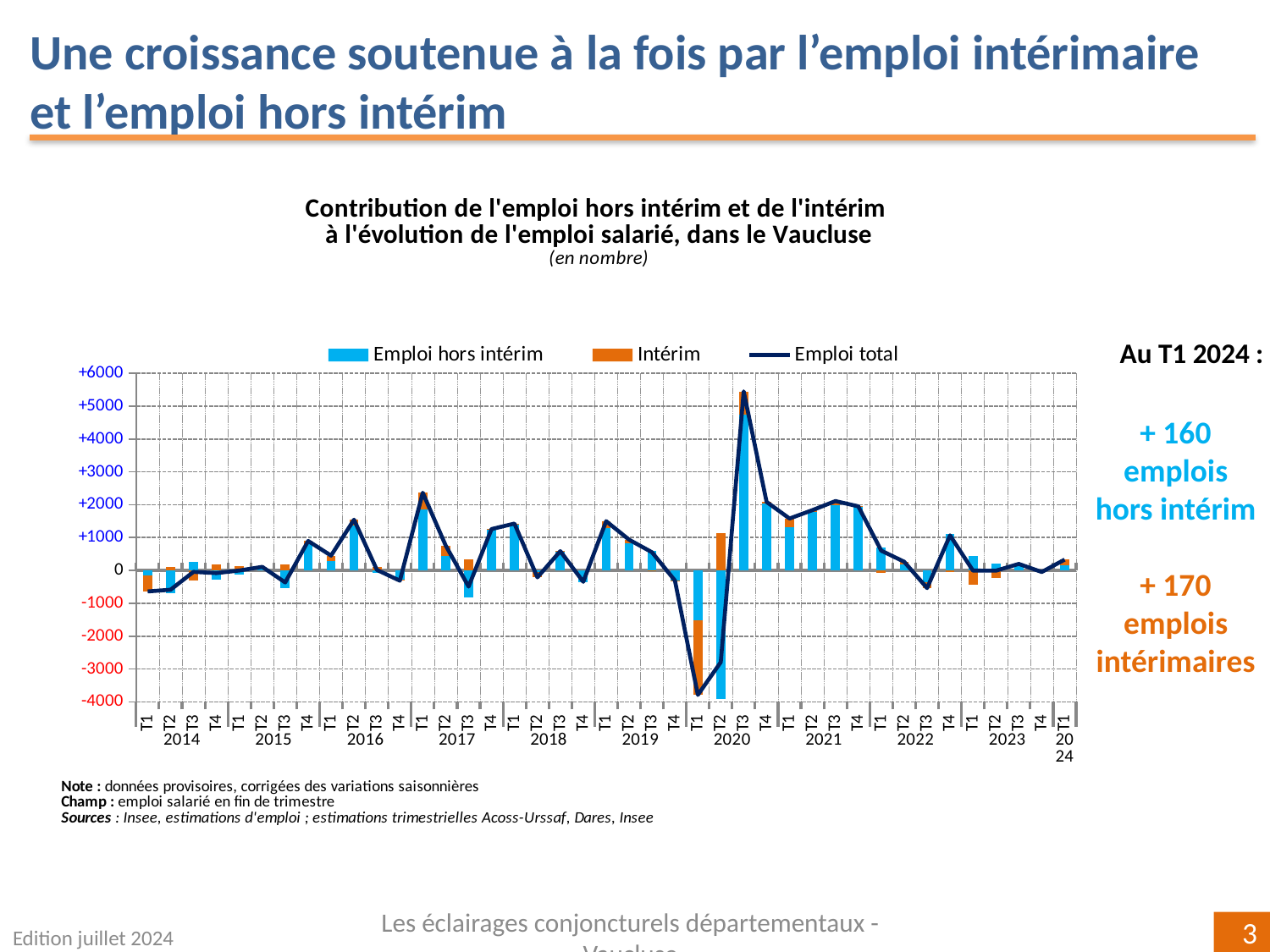
At T1 2024, which is larger: the contribution of emplois hors intérim or emplois intérimaires? Emplois intérimaires How many series does the chart legend list? 3 Is the 'Emploi total' value at T1 2020 greater or less than -3000? less What is the title of the chart? Contribution de l'emploi hors intérim et de l'intérim à l'évolution de l'emploi salarié, dans le Vaucluse Is the 'Emploi total' value at T3 2020 greater or less than +5000? greater What is the difference between the emplois intérimaires (+170) and emplois hors intérim (+160) contributions at T1 2024? 10 In which quarter does the 'Emploi total' line reach its lowest value? T1 2020 In which quarter does the 'Emploi total' line reach its highest value? T3 2020 According to the slide, what is the contribution of 'emplois hors intérim' at T1 2024? + 160 Which colour represents the 'Intérim' series in the chart? Orange According to the slide, what is the contribution of 'emplois intérimaires' at T1 2024? + 170 What kind of chart is shown on the slide? Combined bar and line chart